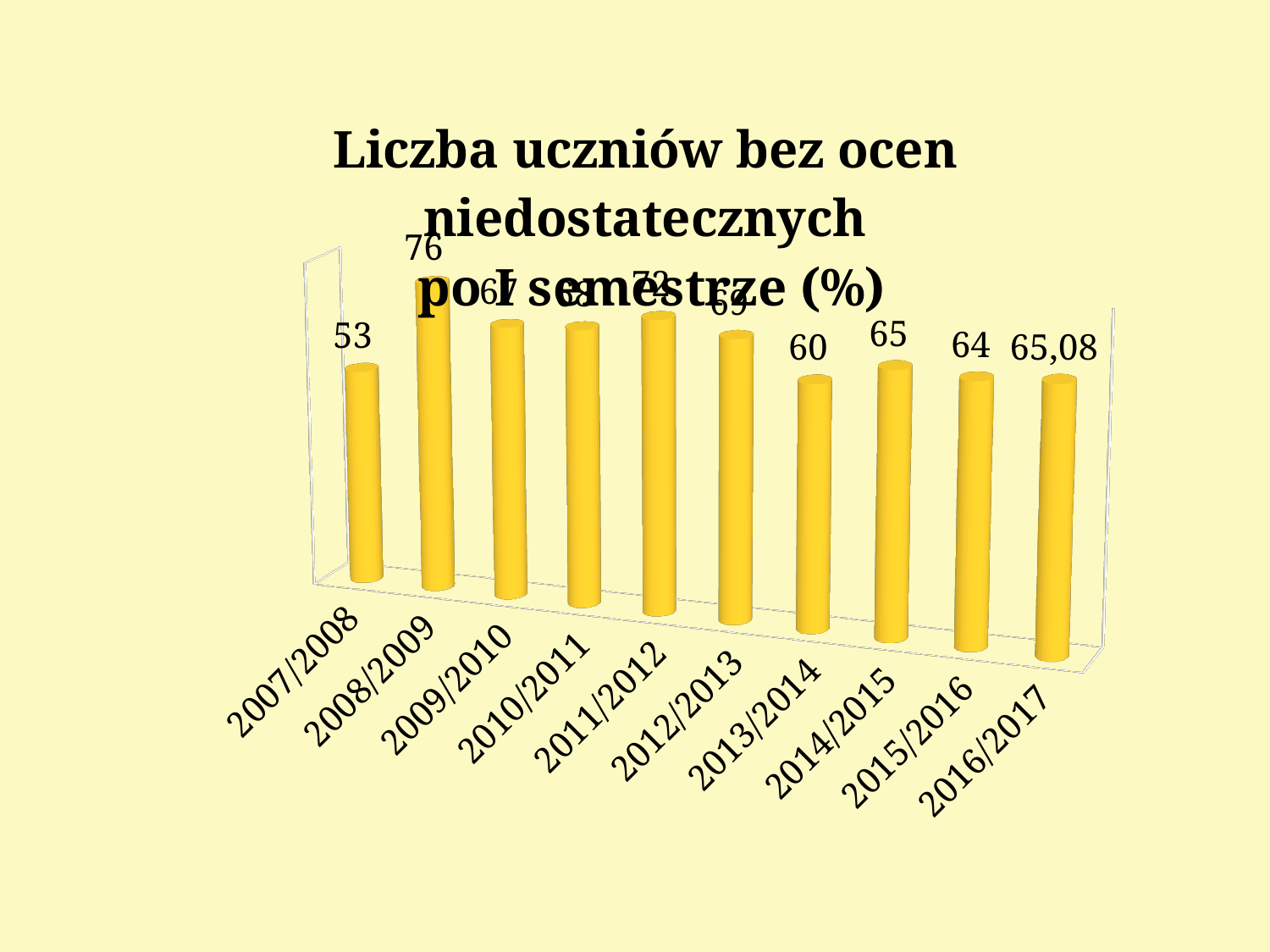
Which school year has the highest value? 2008/2009 What is the difference between the values for 2008/2009 and 2007/2008? 23 What kind of chart is shown on the slide? Bar chart What is the value for 2007/2008? 53 What is the value for 2013/2014? 60 What is the title of the chart? Liczba uczniów bez ocen niedostatecznych po I semestrze (%) What is the value for 2016/2017? 65,08 Which is larger, the value for 2014/2015 or the value for 2013/2014? 2014/2015 Which school year has the lowest value? 2007/2008 How many school years are shown on the chart? 10 What is the value for 2015/2016? 64 What is the value for 2008/2009? 76